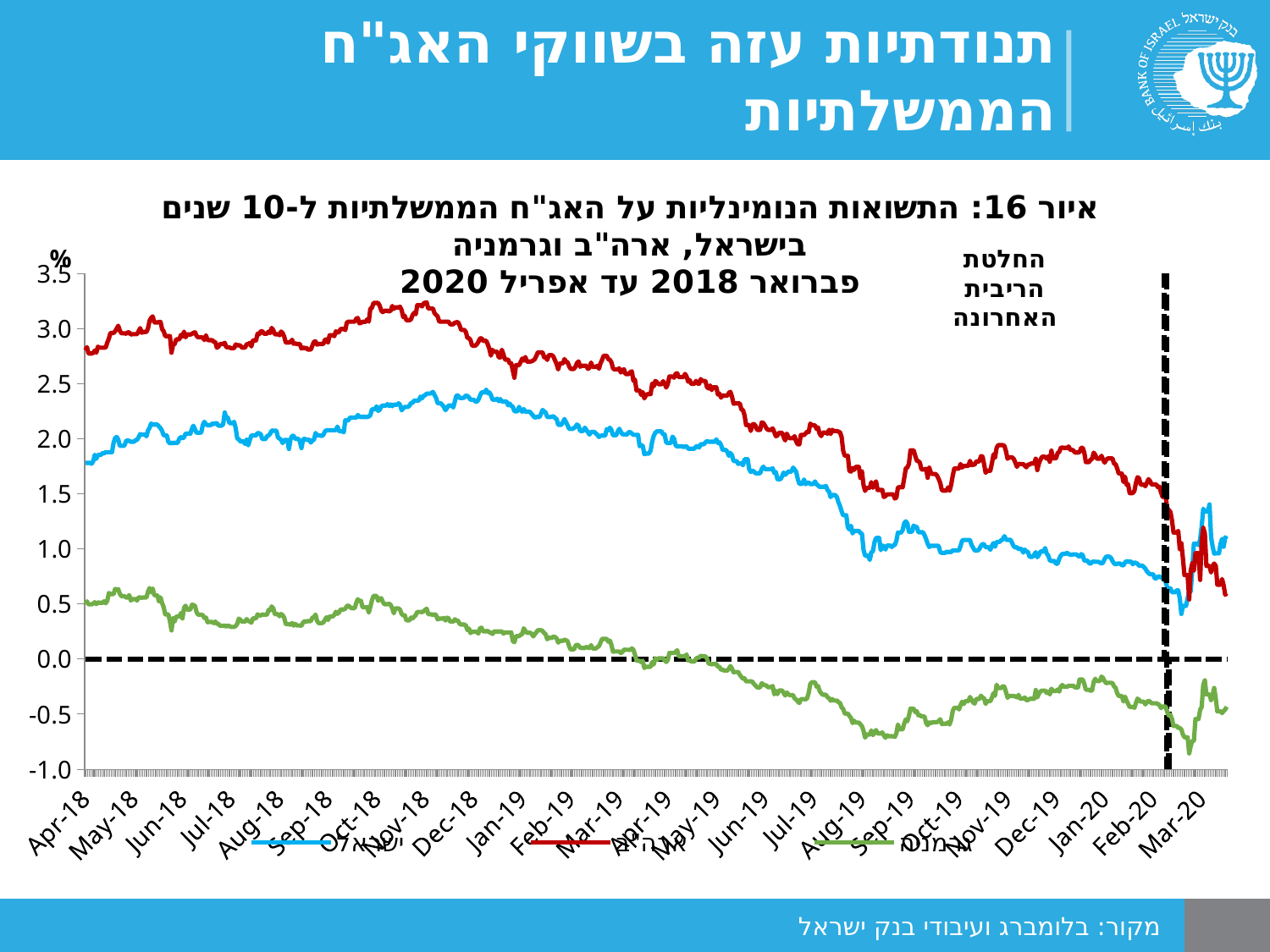
Is the value for ארה"ב in Oct-18 greater or less than 3.0? greater What unit is shown at the top of the y axis? % How many series does the legend list? 3 Is the value for ישראל in Aug-19 greater or less than 1.5? less Is the value for גרמניה in Aug-19 greater or less than 0.0? less Which is larger in Jan-19, the value for ארה"ב or the value for גרמניה? ארה"ב Do the values for ארה"ב rise or fall from Oct-18 to Mar-20? fall Which series has the lowest yield across the whole period shown? גרמניה What kind of chart is shown on the slide? line chart